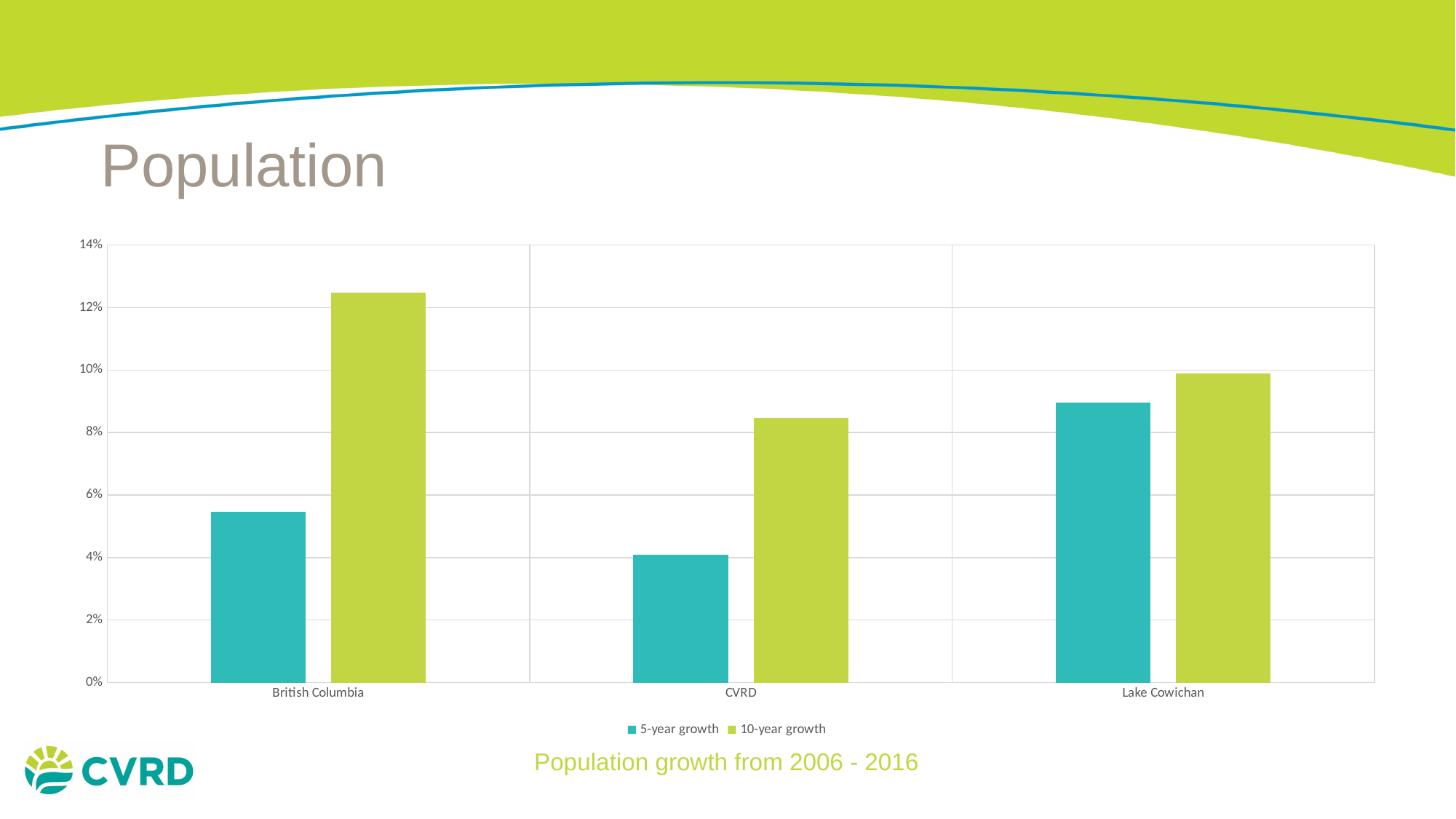
Which category has the highest 10-year growth? British Columbia What kind of chart is shown on the slide? bar chart Is the 5-year growth for British Columbia greater or less than 6%? less Which category has the lowest 5-year growth? CVRD Is the 10-year growth for British Columbia greater or less than 12%? greater Which is larger: the 10-year growth for British Columbia or the 10-year growth for Lake Cowichan? British Columbia Is the 5-year growth for CVRD greater or less than 6%? less Which category has the highest 5-year growth? Lake Cowichan What are the two series named in the chart's legend? 5-year growth and 10-year growth How many series does the chart's legend list? 2 How many categories are shown on the x axis of the chart? 3